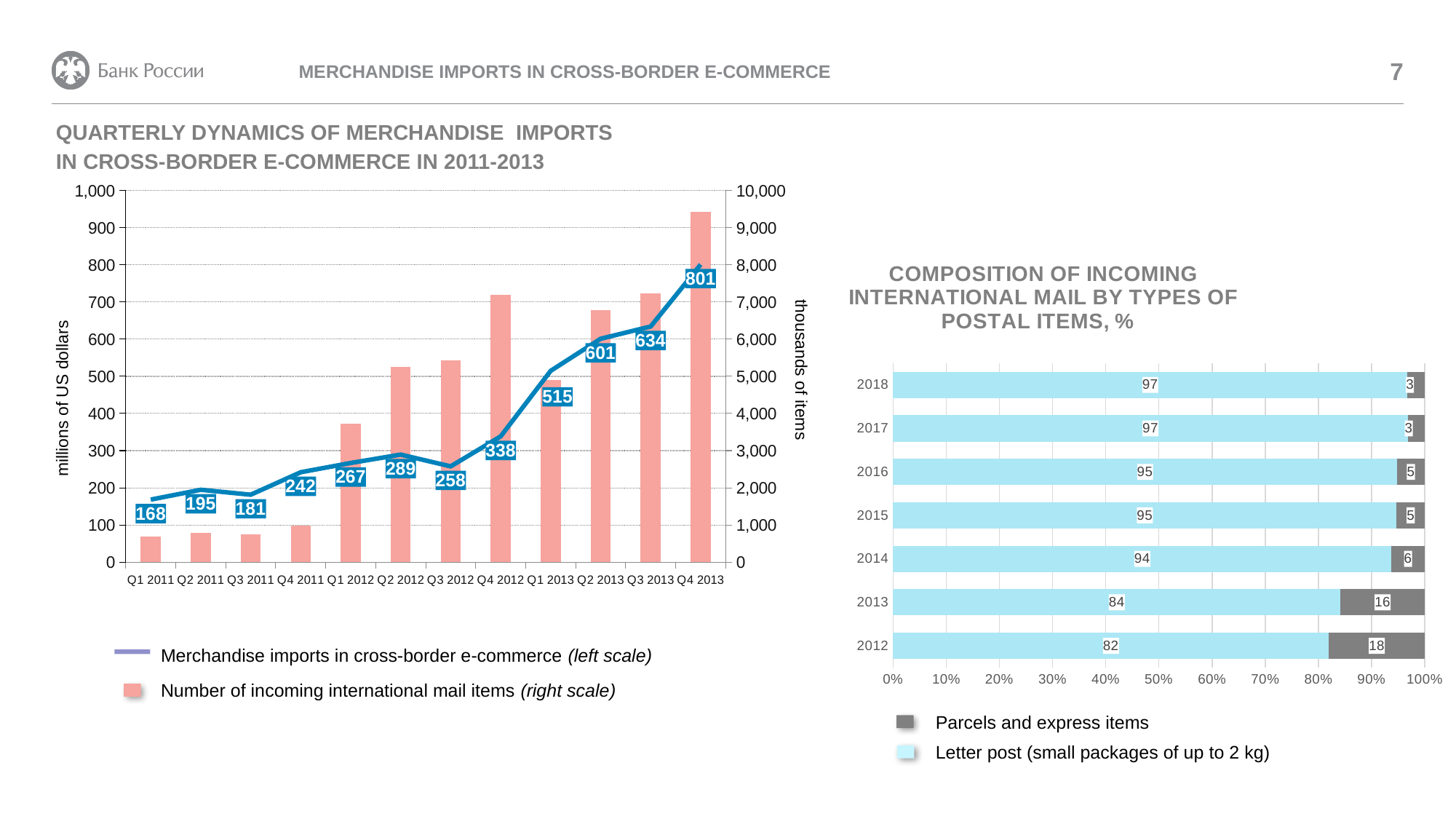
In the composition of incoming international mail chart, which year has the highest share of parcels and express items? 2012 How many series does the legend of the composition of incoming international mail chart list? 2 In the quarterly dynamics chart, is the number of incoming international mail items for Q4 2013 greater or less than 9,000 thousand? greater In the quarterly dynamics chart, which is larger: merchandise imports in Q2 2012 or Q3 2012? Q2 2012 In the quarterly dynamics chart, what is the value of merchandise imports in cross-border e-commerce for Q1 2011? 168 In the composition of incoming international mail chart, what is the difference between the letter post share in 2013 and in 2012? 2 In the quarterly dynamics chart, which quarter has the highest value of merchandise imports in cross-border e-commerce? Q4 2013 In the quarterly dynamics chart, which quarter has the lowest value of merchandise imports in cross-border e-commerce? Q1 2011 In the quarterly dynamics chart, what is the value of merchandise imports in cross-border e-commerce for Q4 2013? 801 In the quarterly dynamics chart, what is the difference between merchandise imports in Q4 2013 and Q1 2013? 286 In the composition of incoming international mail chart, what is the share of parcels and express items in 2012? 18 How many quarters are shown on the x axis of the quarterly dynamics chart? 12